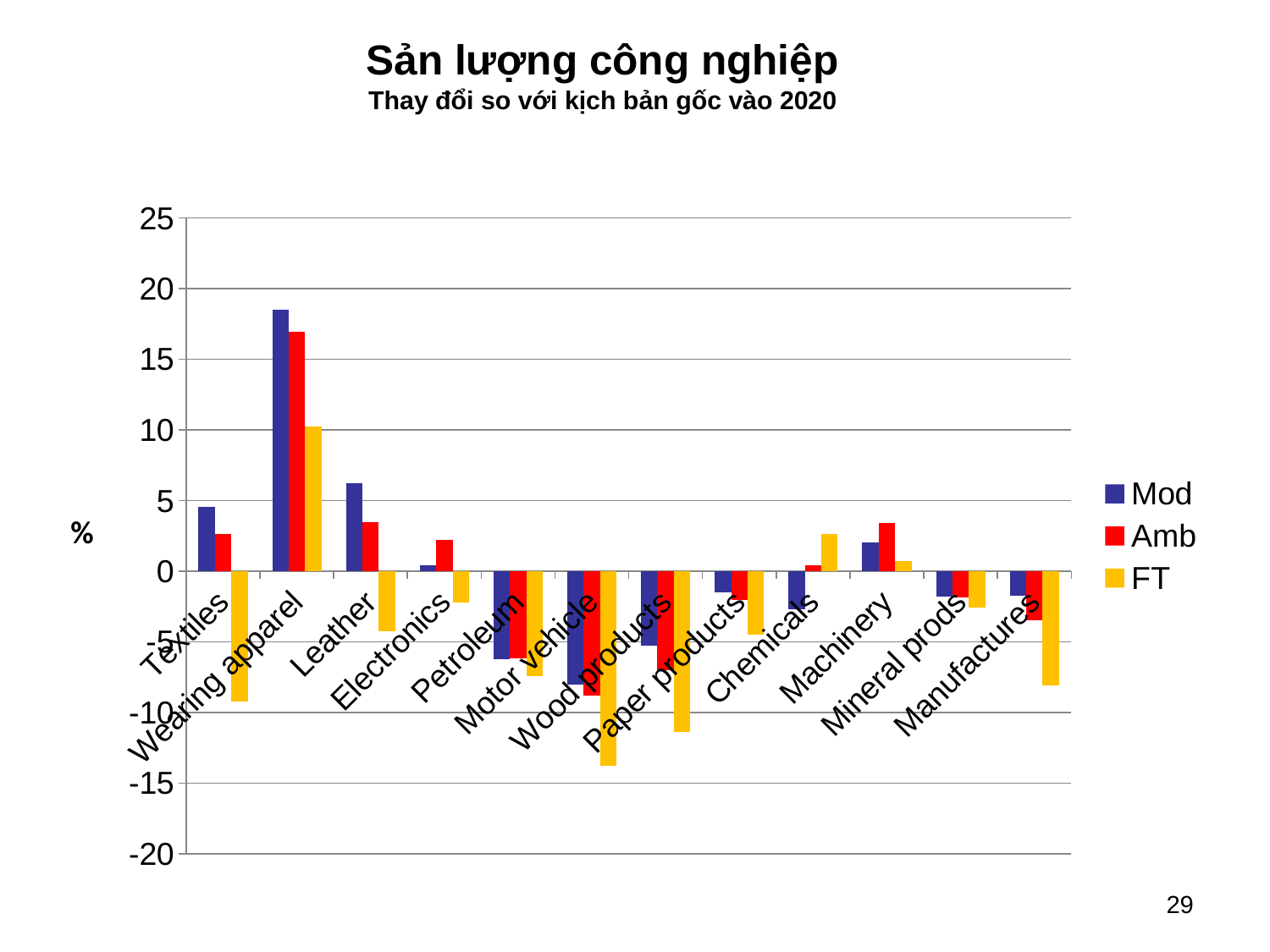
Is the FT value for Wood products greater or less than -10? less Which series is shown in yellow in the legend? FT Is the Mod value for Leather greater or less than 5? greater What kind of chart is shown on the slide? bar chart How many series does the legend list? 3 Is the FT value for Textiles greater or less than -5? less Which category has the lowest FT value? Motor vehicle Which category has the highest Mod value? Wearing apparel For Wearing apparel, which is larger, the Mod value or the Amb value? Mod For Chemicals, which is larger, the FT value or the Mod value? FT How many categories are shown on the x axis? 12